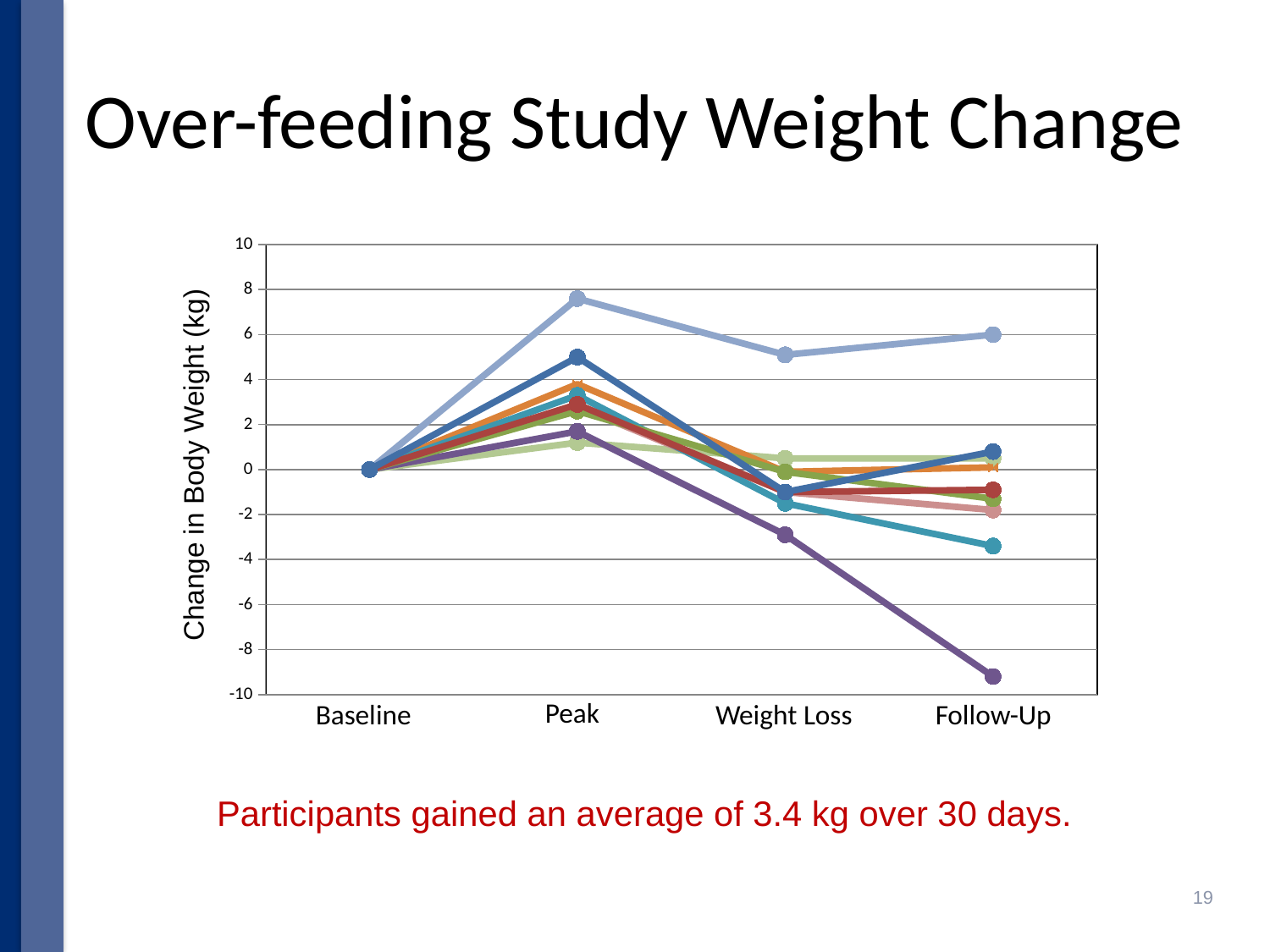
Is the highest value plotted at Peak greater or less than 6? greater Is the highest value plotted at Weight Loss greater or less than 4? greater What kind of chart is shown on the slide? line chart At which x-axis category does the lowest value on the whole chart occur? Follow-Up How many categories are shown on the x axis of the chart? 4 What is the title of the y axis of the chart? Change in Body Weight (kg) What value do all the lines start at for Baseline? 0 Is the lowest value plotted at Follow-Up greater or less than -8? less For the line that is highest at Peak, is its value larger at Peak or at Follow-Up? Peak Do the lines generally rise or fall from Peak to Weight Loss? fall What is the title of the slide containing the chart? Over-feeding Study Weight Change